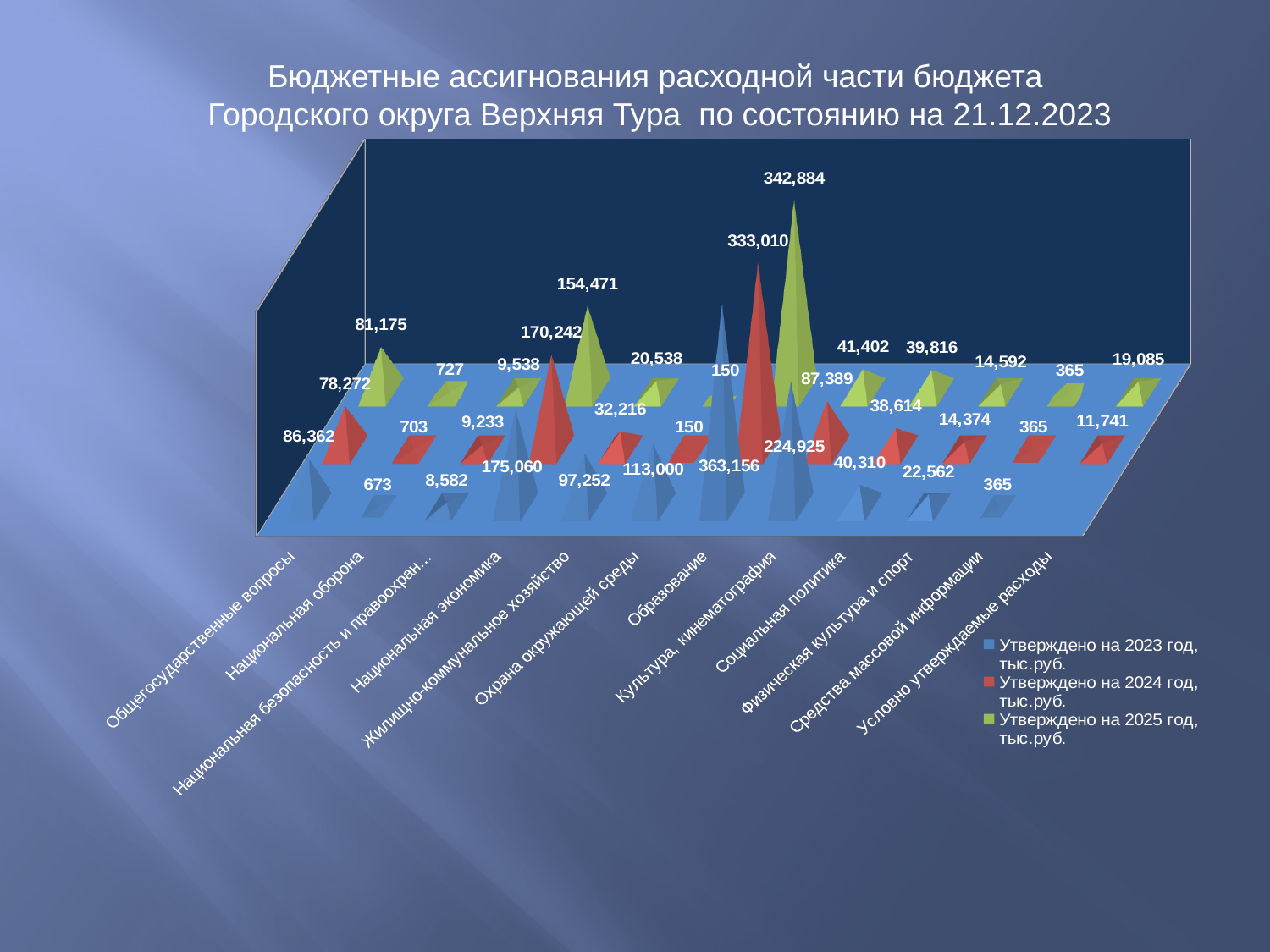
What is the value for Национальная экономика in the series Утверждено на 2024 год, тыс.руб.? 170,242 What is the value for Условно утверждаемые расходы in the series Утверждено на 2025 год, тыс.руб.? 19,085 What is the value for Образование in the series Утверждено на 2024 год, тыс.руб.? 333,010 Which category has the highest value in the series Утверждено на 2025 год, тыс.руб.? Образование What kind of chart is shown on the slide? bar chart How many series does the legend list? 3 How many categories are shown along the x axis? 12 What is the value for Образование in the series Утверждено на 2023 год, тыс.руб.? 363,156 What is the value for Образование in the series Утверждено на 2025 год, тыс.руб.? 342,884 What date is given in the chart title? 21.12.2023 What is the difference between the 2025 and 2024 values for Образование? 9,874 For Образование, which is larger: the value for 2023 or the value for 2025? 2023